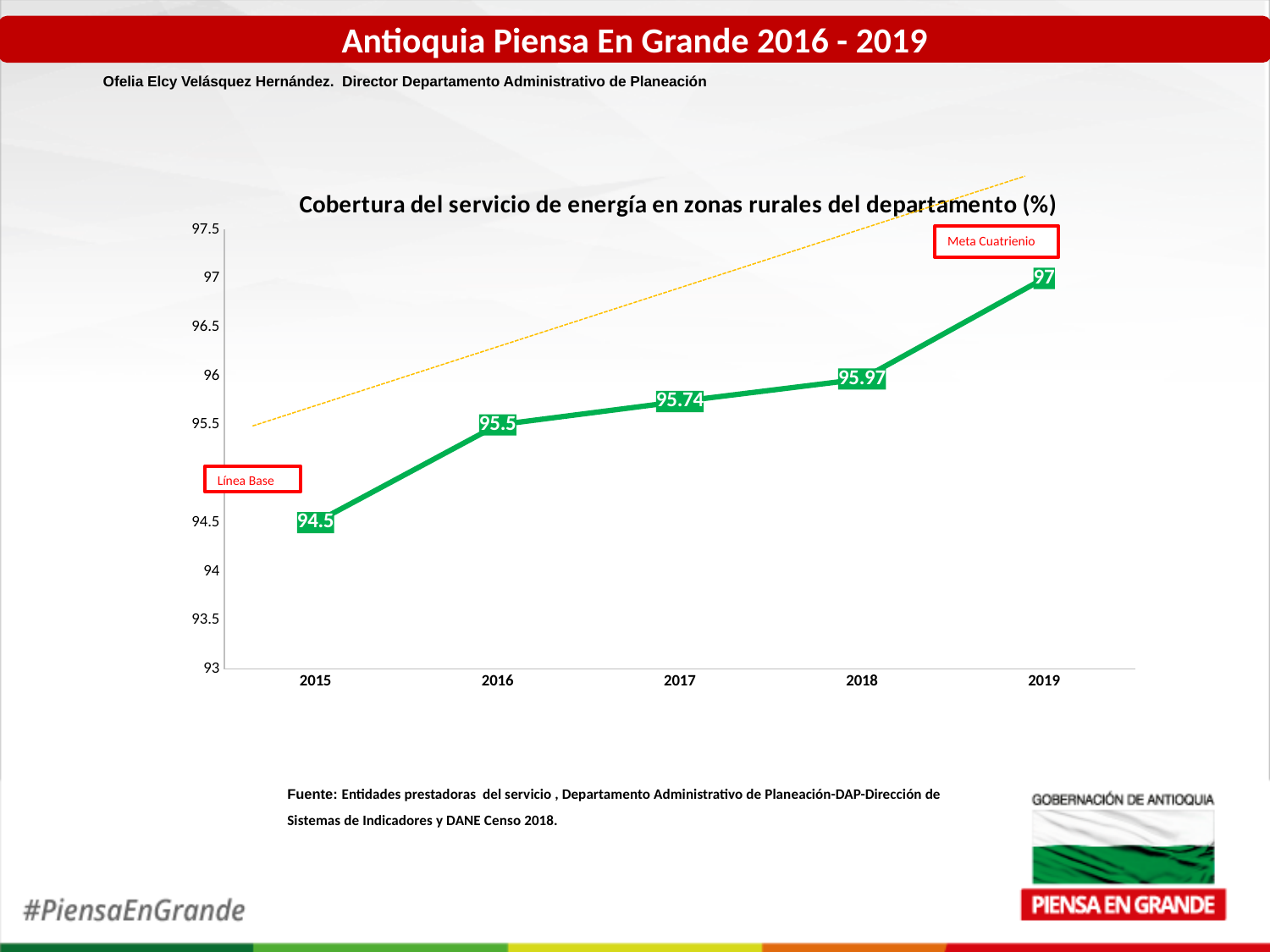
How many years are plotted on the x axis? 5 What is the value for 2015? 94.5 Which is larger, the value for 2016 or the value for 2018? 2018 What kind of chart is shown? line chart Is the value for 2016 greater or less than 96? less What is the difference between the values for 2019 and 2015? 2.5 What is the value for 2019? 97 Do the values rise or fall from 2015 to 2019? rise Which year has the highest value? 2019 What is the value for 2017? 95.74 Which year has the lowest value? 2015 What is the difference between the values for 2018 and 2017? 0.23